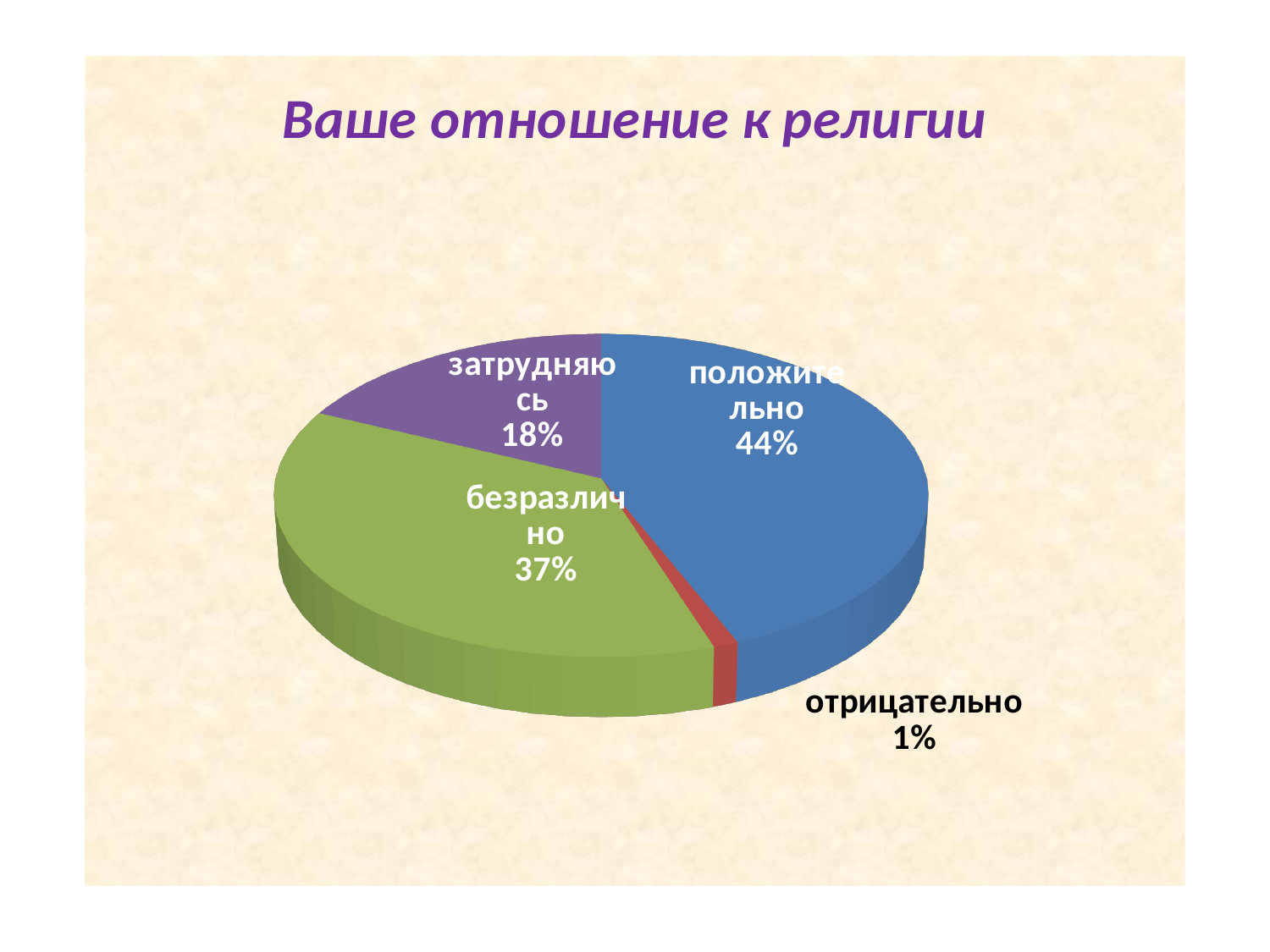
What is the difference between the shares for "положительно" and "безразлично"? 7% What type of chart is shown on the slide? pie chart What colour is the slice for "безразлично"? green Which category has the smallest share of the pie? отрицательно How many categories are shown in the pie chart? 4 Which is larger, the share for "безразлично" or the share for "затрудняюсь"? безразлично What percentage of respondents answered "безразлично"? 37% What is the title of the chart? Ваше отношение к религии Which category has the largest share of the pie? положительно What percentage of respondents answered "отрицательно"? 1% What percentage of respondents answered "положительно"? 44% What percentage of respondents answered "затрудняюсь"? 18%